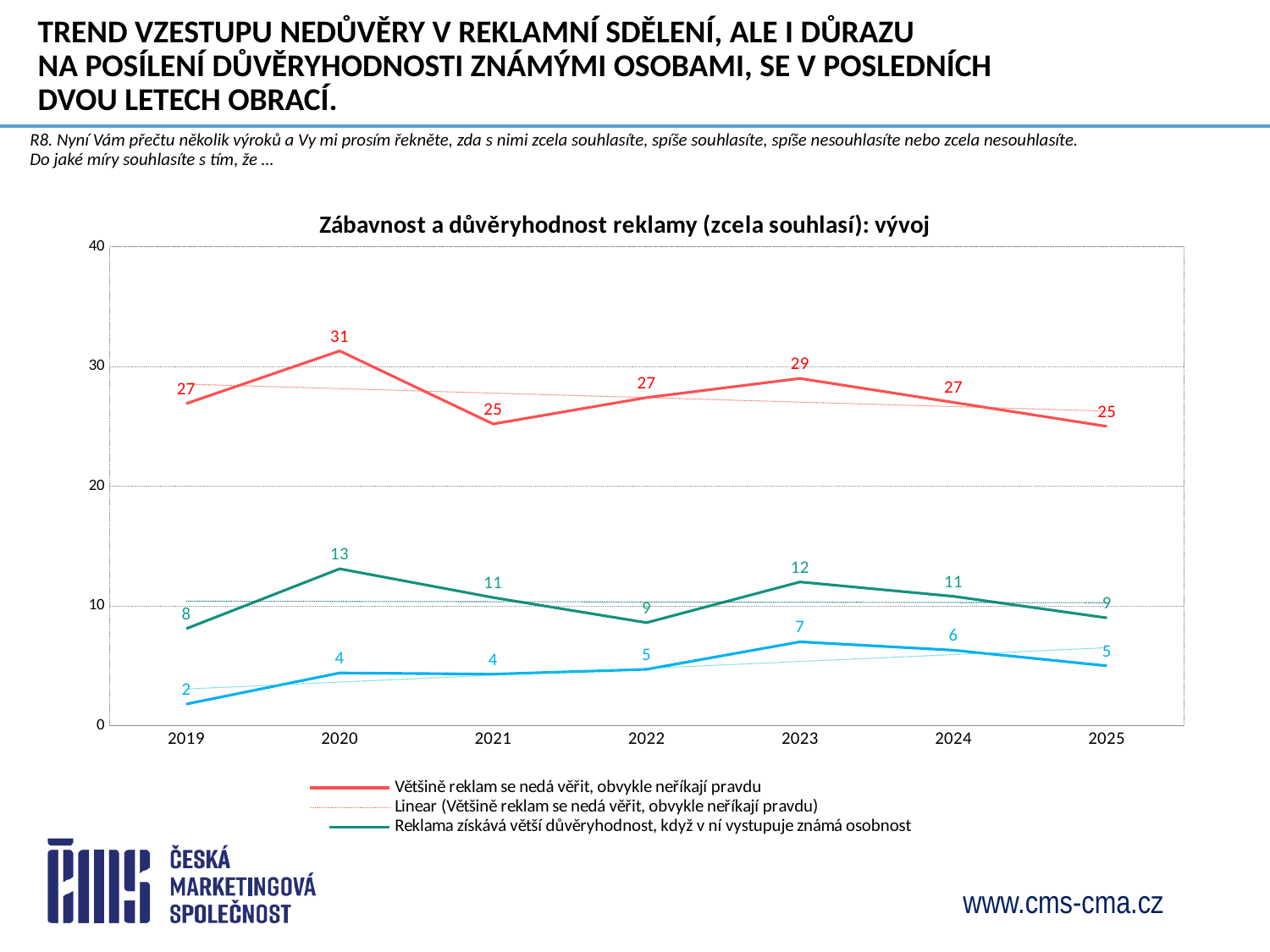
In which year is 'Reklama získává větší důvěryhodnost, když v ní vystupuje známá osobnost' lowest? 2019 What is the difference between the 2020 and 2021 values for 'Většině reklam se nedá věřit, obvykle neříkají pravdu'? 6 Is the 2025 value for 'Většině reklam se nedá věřit, obvykle neříkají pravdu' greater or less than 20? greater What is the value for 'Reklama získává větší důvěryhodnost, když v ní vystupuje známá osobnost' in 2023? 12 What is the value for 'Většině reklam se nedá věřit, obvykle neříkají pravdu' in 2020? 31 How many years are shown on the x axis? 7 What is the value for 'Většině reklam se nedá věřit, obvykle neříkají pravdu' in 2025? 25 In which year is 'Většině reklam se nedá věřit, obvykle neříkají pravdu' highest? 2020 Does the value for 'Většině reklam se nedá věřit, obvykle neříkají pravdu' rise or fall from 2023 to 2025? fall For 'Reklama získává větší důvěryhodnost, když v ní vystupuje známá osobnost', which year has the larger value, 2020 or 2025? 2020 What is the difference between the 2020 and 2019 values for 'Reklama získává větší důvěryhodnost, když v ní vystupuje známá osobnost'? 5 What kind of chart is shown on the slide? line chart